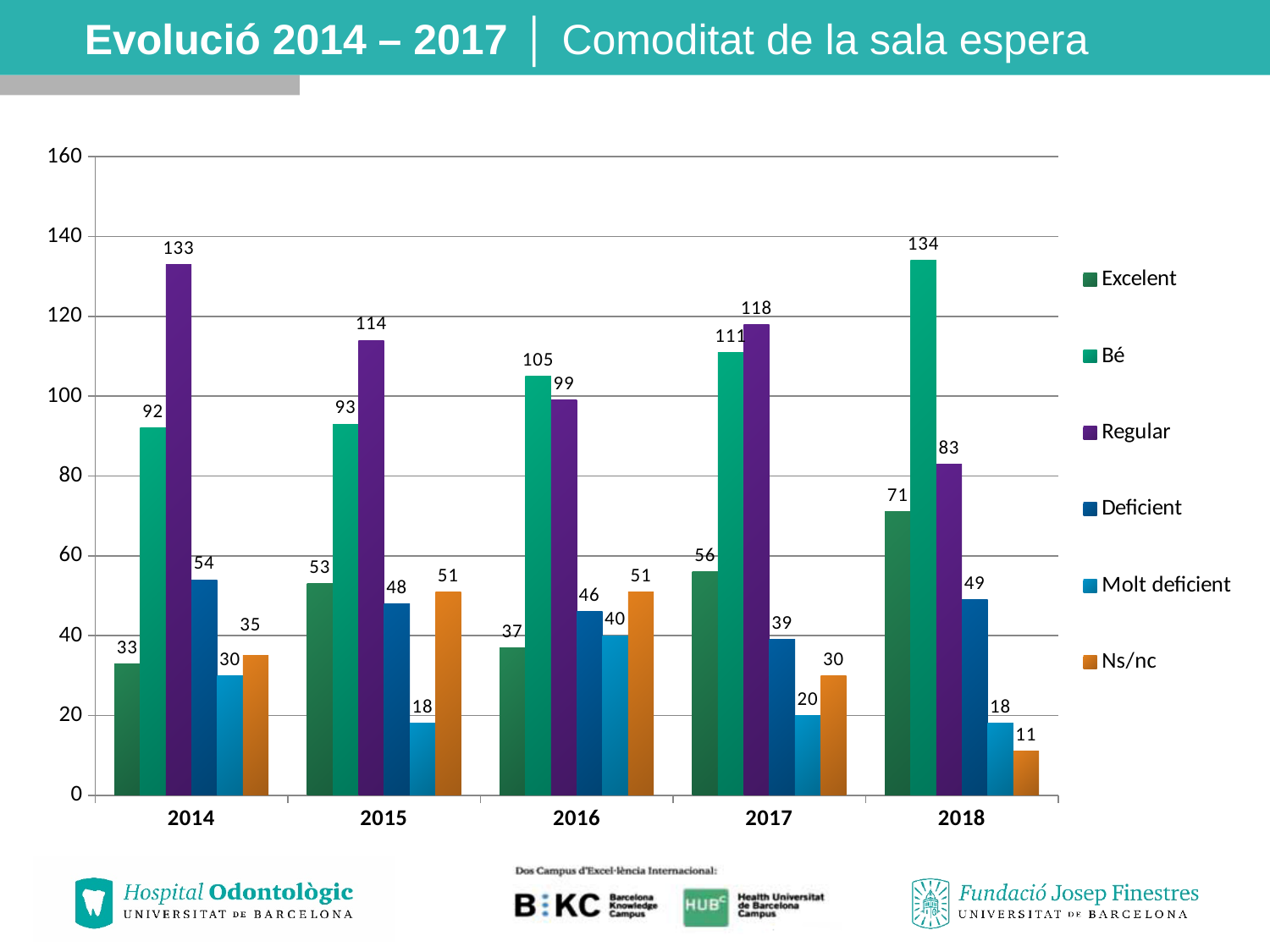
Which series is shown in purple in the legend? Regular In which year is the Molt deficient value lowest? 2015 and 2018 How many years are shown on the x axis? 5 What is the difference between the Regular value in 2014 and the Regular value in 2018? 50 What is the value for Bé in 2018? 134 What is the value for Ns/nc in 2018? 11 Does the Excelent value rise or fall from 2017 to 2018? rise Which is larger in 2016, the value for Bé or the value for Regular? Bé In which year is the Excelent value highest? 2018 How many series does the legend list? 6 What kind of chart is shown on the slide? bar chart What is the value for Regular in 2014? 133